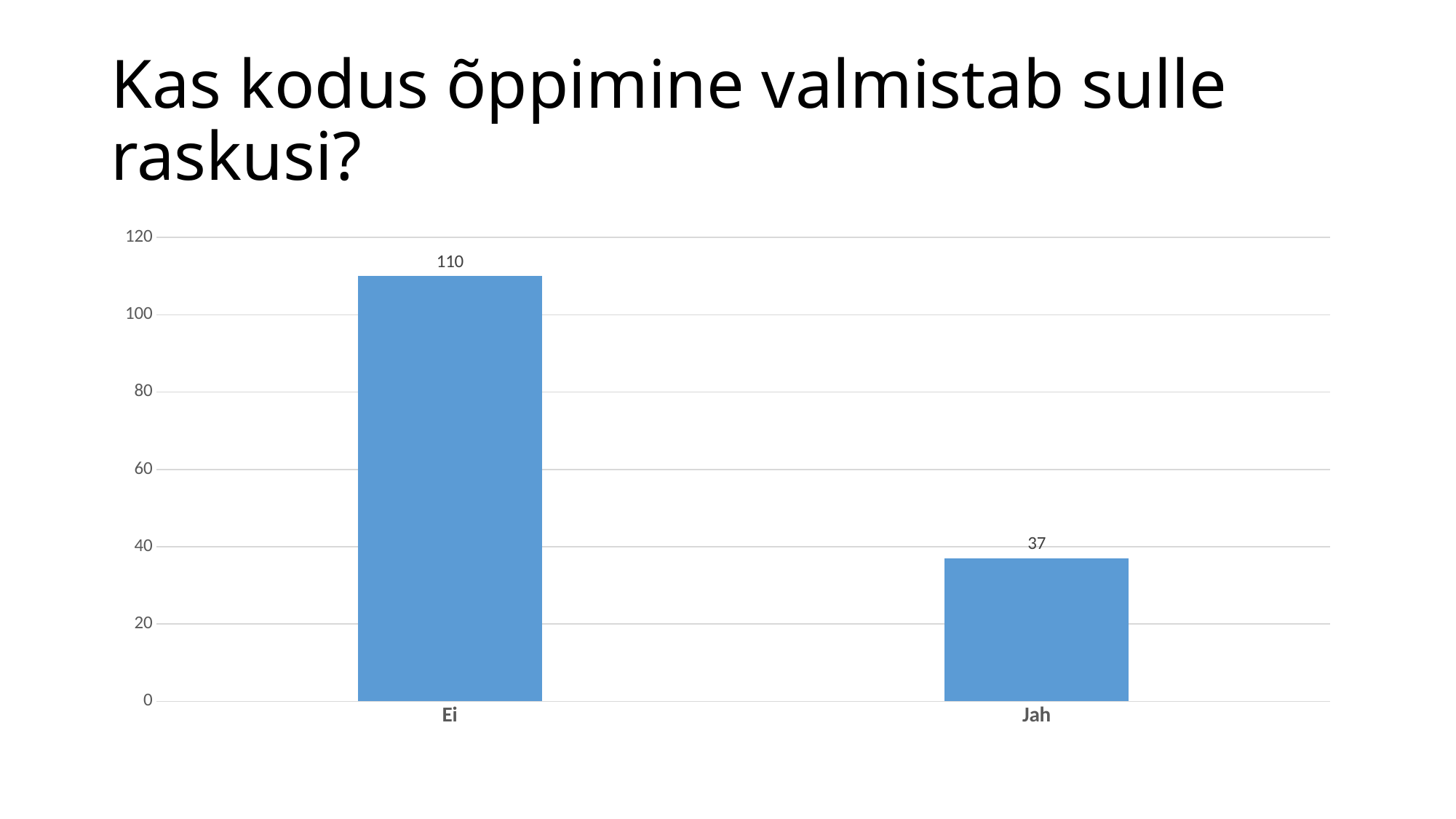
Which category has the lowest value? Jah What kind of chart is shown on the slide? bar chart What is the value for Ei? 110 Is the value for Ei greater or less than 100? greater What is the value for Jah? 37 What is the title of the slide? Kas kodus õppimine valmistab sulle raskusi? Is the value for Jah greater or less than 40? less Which is larger, the value for Ei or the value for Jah? Ei What is the difference between the values for Ei and Jah? 73 What is the highest value shown on the y axis? 120 How many categories are shown on the x axis? 2 Which category has the highest value? Ei